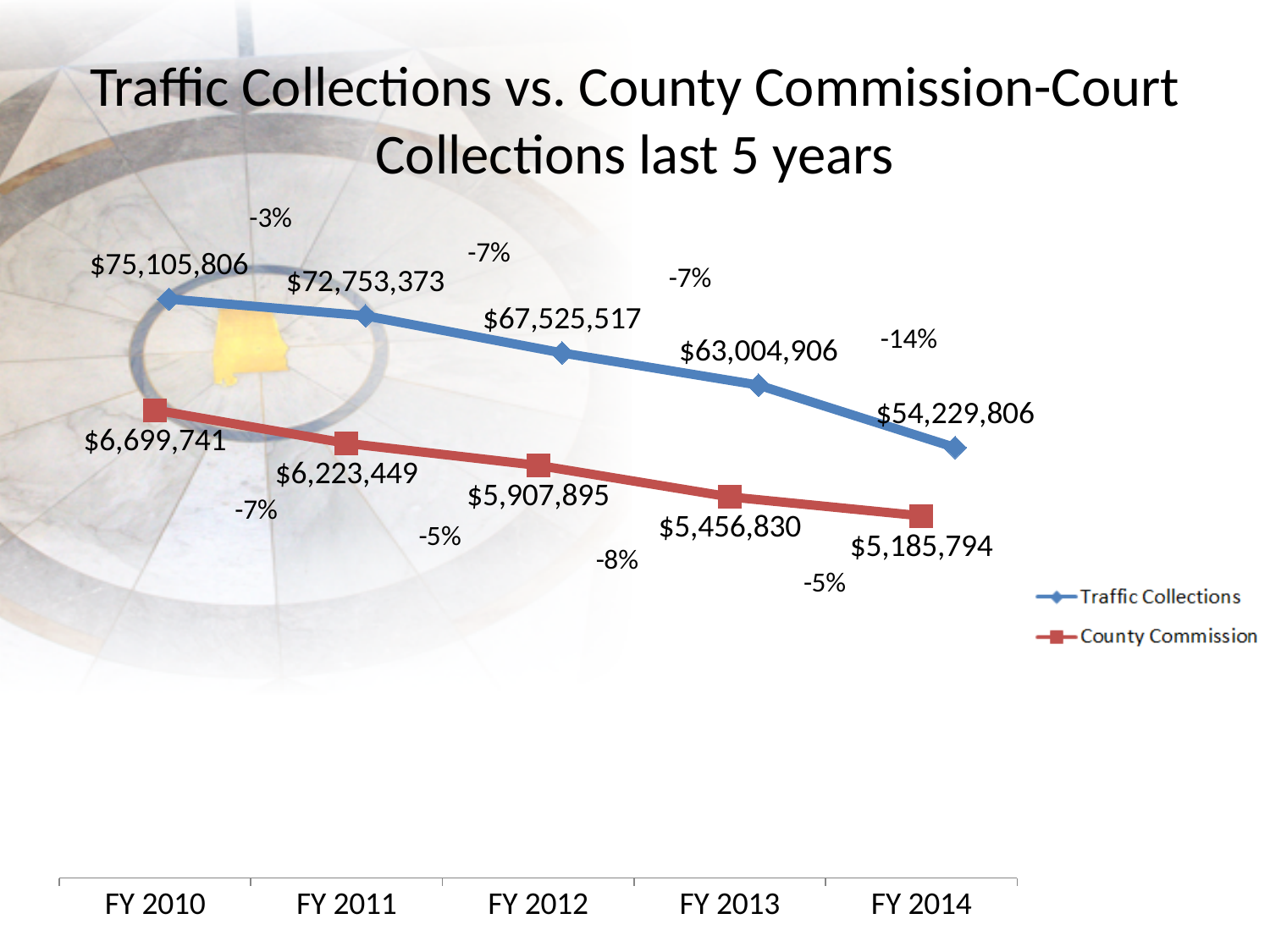
What type of chart is shown on the slide? Line chart What is the difference between County Commission collections in FY 2010 and FY 2014? $1,513,947 In which fiscal year are Traffic Collections lowest? FY 2014 In which fiscal year are County Commission collections highest? FY 2010 What is the difference between Traffic Collections in FY 2010 and FY 2014? $20,876,000 What is the value of County Commission collections in FY 2013? $5,456,830 How many series does the legend list? 2 How many fiscal years are shown on the x axis? 5 What is the value of Traffic Collections in FY 2012? $67,525,517 What is the value of Traffic Collections in FY 2010? $75,105,806 What is the value of County Commission collections in FY 2014? $5,185,794 Which series has the larger value in FY 2011, Traffic Collections or County Commission? Traffic Collections